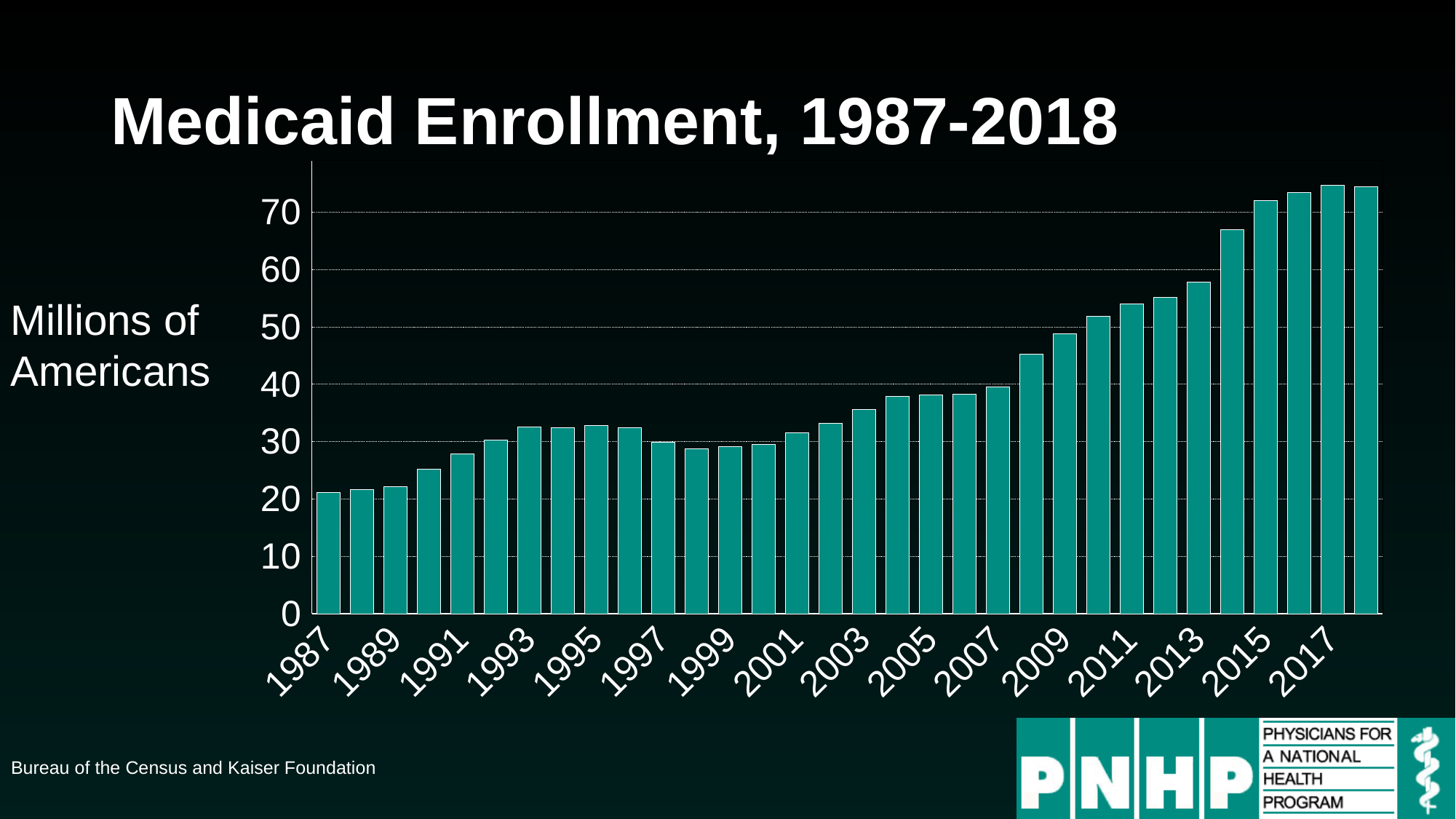
What unit does the vertical axis represent, according to the label beside the chart? Millions of Americans What kind of chart is shown on the slide? Bar chart What is the title of the chart? Medicaid Enrollment, 1987-2018 How many bars (years) are plotted in the chart? 32 Overall, do the values rise or fall from 1987 to 2018? Rise Which year has the larger value, 2005 or 2015? 2015 Is the value for 2013 greater or less than 50? greater Is the value for 2015 greater or less than 60? greater Is the value for 2005 greater or less than 40? less Which year has the larger value, 1999 or 2009? 2009